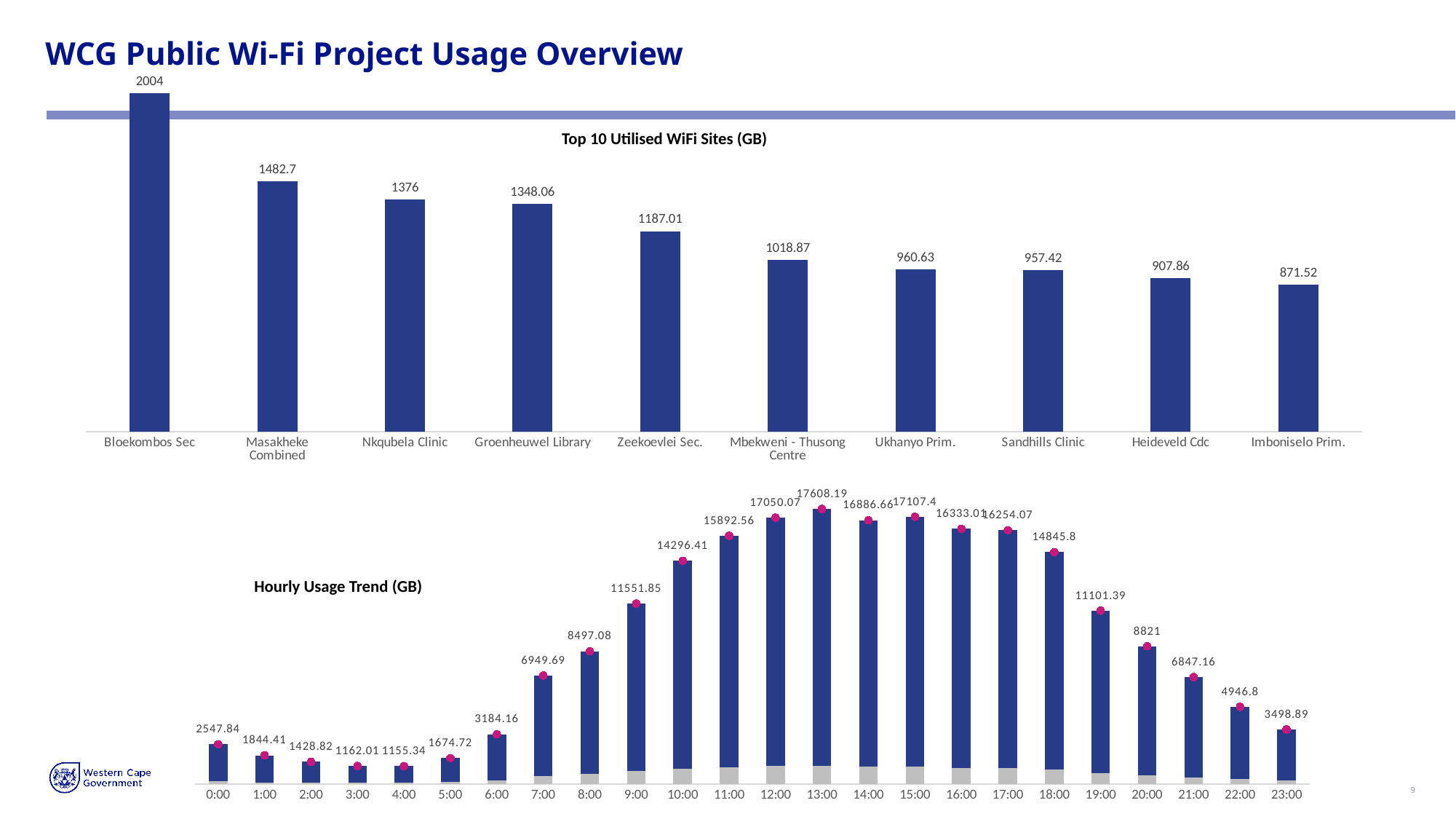
In the Hourly Usage Trend (GB) chart, how many hourly points are plotted? 24 In the Top 10 Utilised WiFi Sites (GB) chart, what is the value for Bloekombos Sec? 2004 In the Hourly Usage Trend (GB) chart, which hour has the highest value? 13:00 In the Hourly Usage Trend (GB) chart, what is the value at 13:00? 17608.19 In the Top 10 Utilised WiFi Sites (GB) chart, which is larger, Nkqubela Clinic or Zeekoevlei Sec.? Nkqubela Clinic In the Hourly Usage Trend (GB) chart, what is the value at 4:00? 1155.34 What kind of chart is the Top 10 Utilised WiFi Sites (GB) chart? bar chart In the Top 10 Utilised WiFi Sites (GB) chart, how many sites are shown? 10 In the Top 10 Utilised WiFi Sites (GB) chart, which site has the lowest value? Imboniselo Prim. In the Hourly Usage Trend (GB) chart, do the values rise or fall from 13:00 to 23:00? fall In the Top 10 Utilised WiFi Sites (GB) chart, what is the value for Groenheuwel Library? 1348.06 In the Top 10 Utilised WiFi Sites (GB) chart, what is the difference between Bloekombos Sec and Masakheke Combined? 521.3